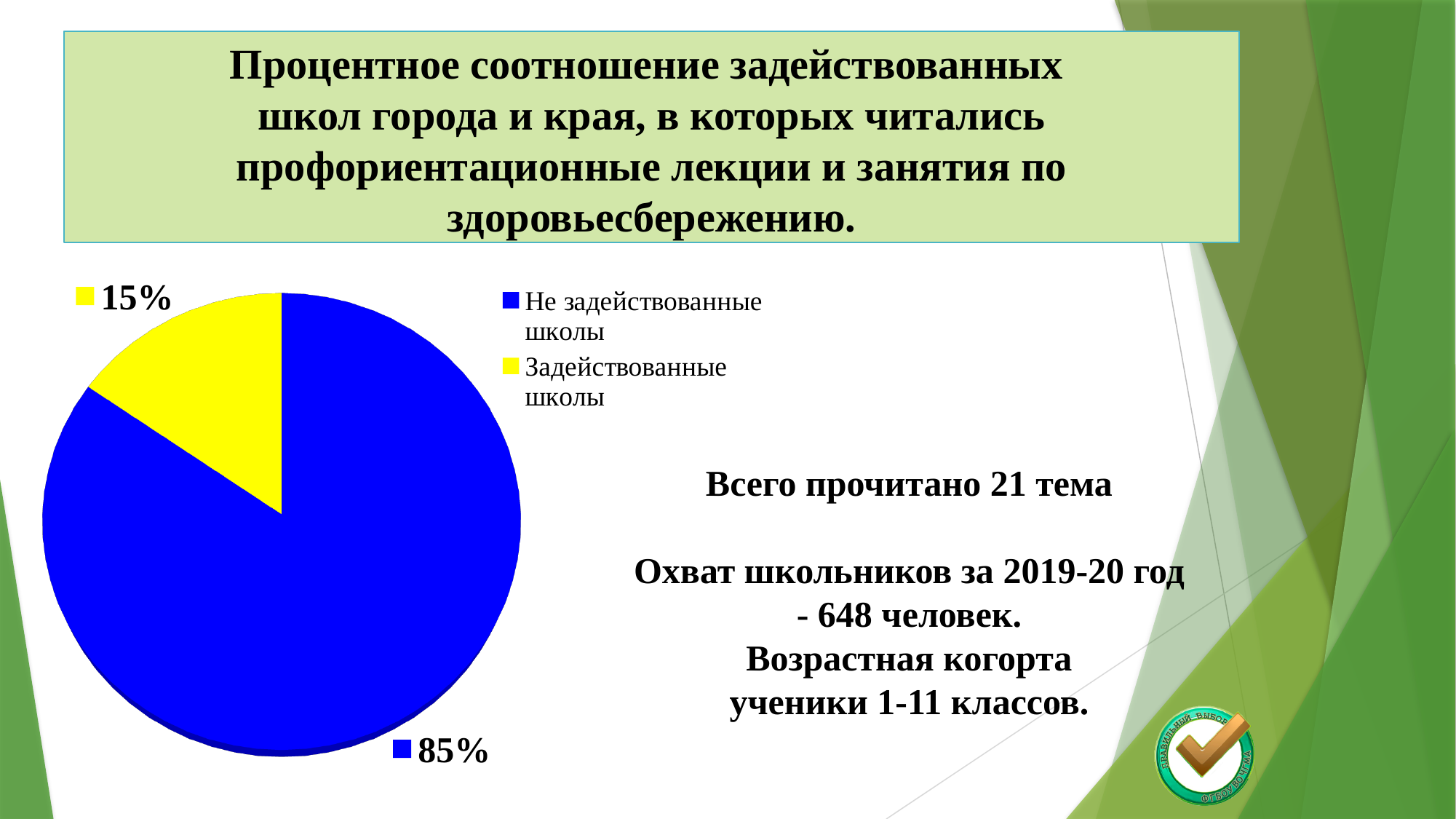
Which category has the smallest slice of the pie? Задействованные школы Which is larger: the share for "Задействованные школы" or for "Не задействованные школы"? Не задействованные школы What kind of chart is shown on the slide? pie chart What colour is the slice for "Задействованные школы"? yellow What percentage of the pie is labelled for "Задействованные школы"? 15% How many entries does the legend list? 2 What percentage of the pie is labelled for "Не задействованные школы"? 85% What is the difference in percentage points between "Не задействованные школы" and "Задействованные школы"? 70 What colour is the slice for "Не задействованные школы"? blue Which category has the largest slice of the pie? Не задействованные школы How many slices does the pie chart have? 2